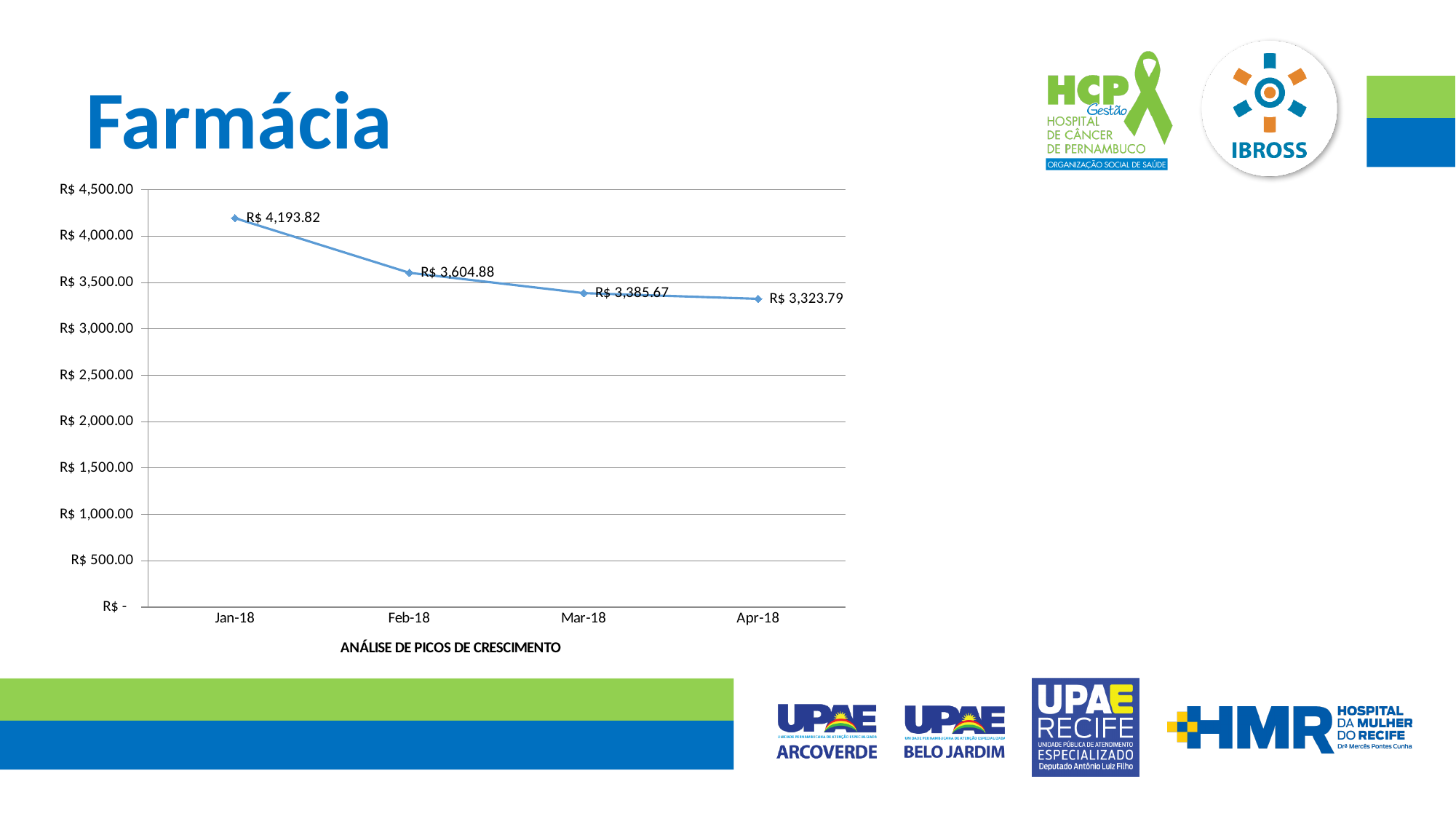
What kind of chart is shown on the slide? Line chart What is the value for Apr-18? R$ 3,323.79 Which month has the highest value? Jan-18 How many months are plotted on the chart? 4 What is the value for Jan-18? R$ 4,193.82 Which is larger, the value for Feb-18 or the value for Mar-18? Feb-18 Do the values rise or fall from Jan-18 to Apr-18? Fall What is the difference between the values for Mar-18 and Apr-18? R$ 61.88 What is the value for Feb-18? R$ 3,604.88 What is the difference between the values for Jan-18 and Feb-18? R$ 588.94 What is the value for Mar-18? R$ 3,385.67 Which month has the lowest value? Apr-18